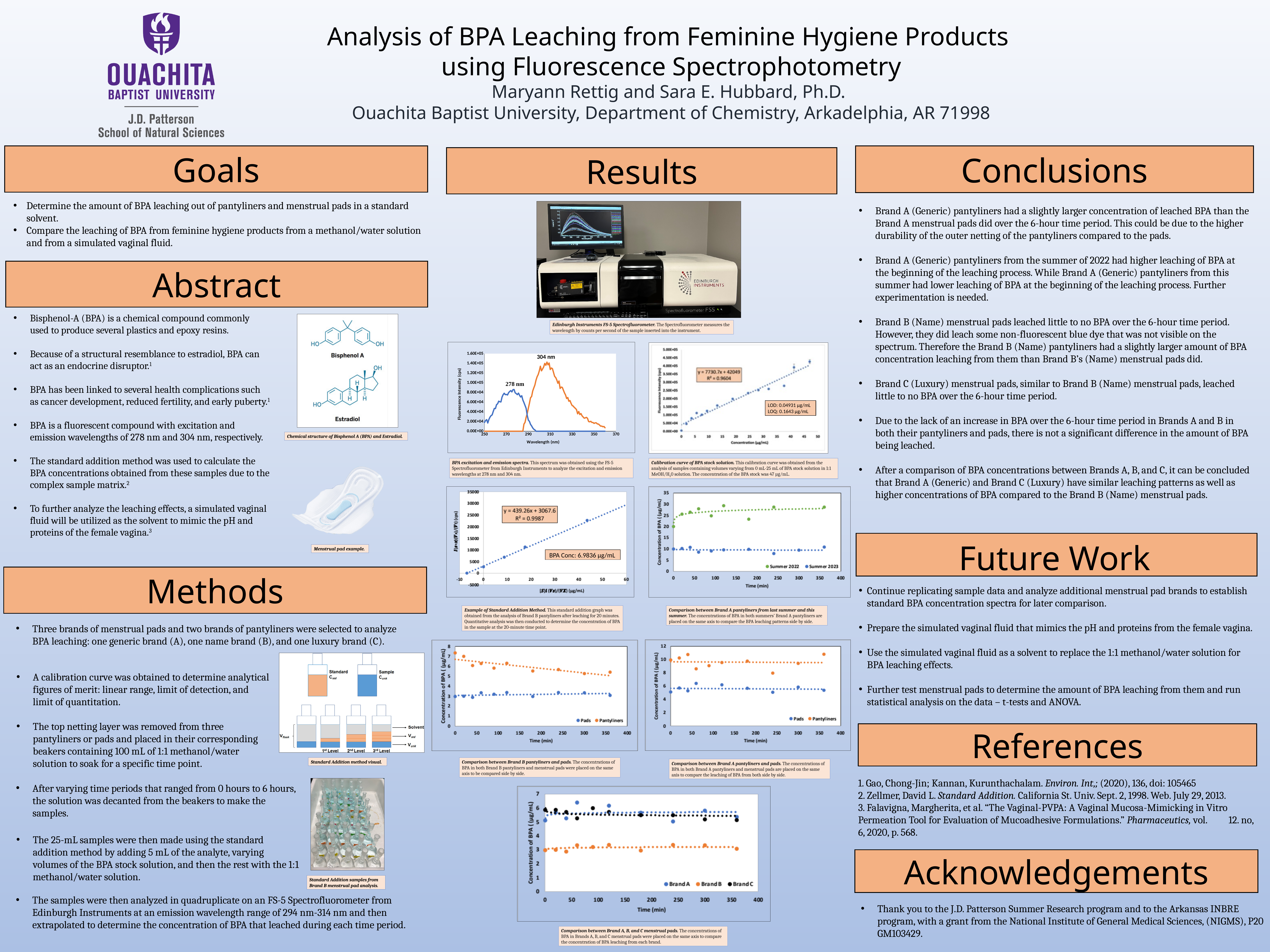
In the 'Comparison between Brand A pantyliners from last summer and this summer' chart, are the Summer 2023 values greater or less than 15 µg/mL? less In the 'Comparison between Brand A, B, and C menstrual pads' chart, which brand has the lowest BPA concentrations? Brand B In the 'Calibration curve of BPA stock solution' chart, what LOD value is printed? 0.04931 µg/mL In the 'Comparison between Brand A pantyliners from last summer and this summer' chart, which series has the higher BPA concentrations, Summer 2022 or Summer 2023? Summer 2022 In the 'BPA excitation and emission spectra' chart, at what wavelength is the emission peak labelled? 304 nm In the 'Calibration curve of BPA stock solution' chart, what is the R² value shown for the trendline? R² = 0.9604 In the 'BPA excitation and emission spectra' chart, at what wavelength is the excitation peak labelled? 278 nm In the 'Comparison between Brand A pantyliners from last summer and this summer' chart, how many series does the legend list? 2 In the 'Example of Standard Addition Method' chart, what trendline equation is shown? y = 439.26x + 3067.6 In the 'Comparison between Brand B pantyliners and pads' chart, which series has the higher BPA concentrations, Pads or Pantyliners? Pantyliners In the 'Example of Standard Addition Method' chart, what BPA concentration is printed? 6.9836 µg/mL In the 'Comparison between Brand A, B, and C menstrual pads' chart, how many series does the legend list? 3